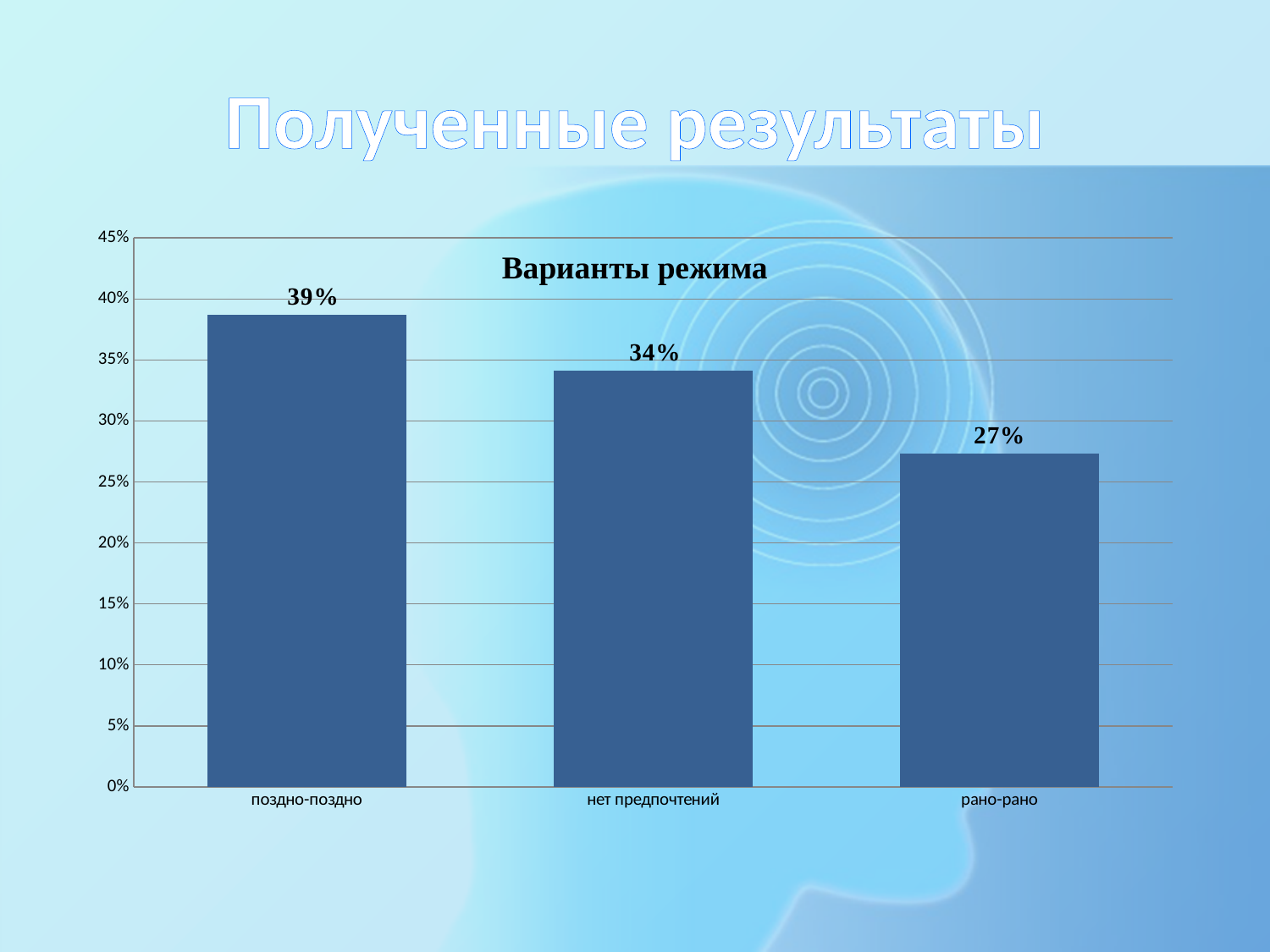
What is the value for рано-рано? 27% Is the value for рано-рано greater or less than 30%? less Which category has the highest value? поздно-поздно What is the value for поздно-поздно? 39% What kind of chart is shown on the slide? bar chart How many categories are shown on the chart? 3 What is the value for нет предпочтений? 34% What is the title of the chart? Варианты режима Which category has the lowest value? рано-рано What is the difference between the values for нет предпочтений and рано-рано? 7% Which is larger, the value for нет предпочтений or the value for рано-рано? нет предпочтений What is the difference between the values for поздно-поздно and рано-рано? 12%